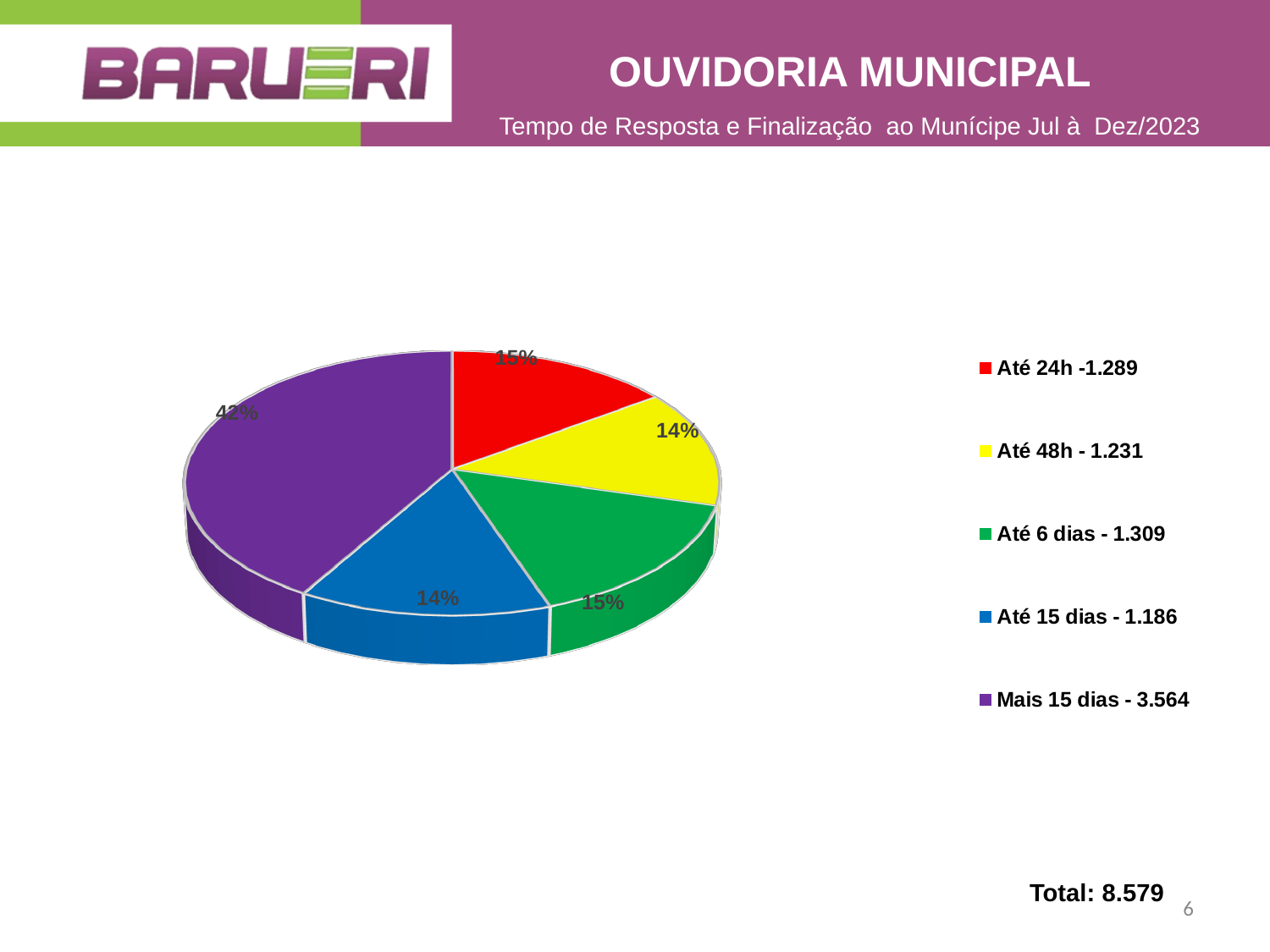
How many cases are listed for 'Até 15 dias' in the legend? 1.186 Which category has the largest slice of the pie? Mais 15 dias What share of the pie does the 'Mais 15 dias' slice represent? 42% What share of the pie does the 'Até 48h' slice represent? 14% How many slices does the pie chart have? 5 Which has more cases, 'Até 6 dias' or 'Até 48h'? Até 6 dias What kind of chart is shown on the slide? pie chart Which category has the smallest number of cases according to the legend? Até 15 dias What share of the pie does the 'Até 24h' slice represent? 15% How many cases are listed for 'Até 6 dias' in the legend? 1.309 What is the difference between the number of cases for 'Mais 15 dias' and 'Até 24h'? 2.275 What total is shown on the slide for all categories? 8.579